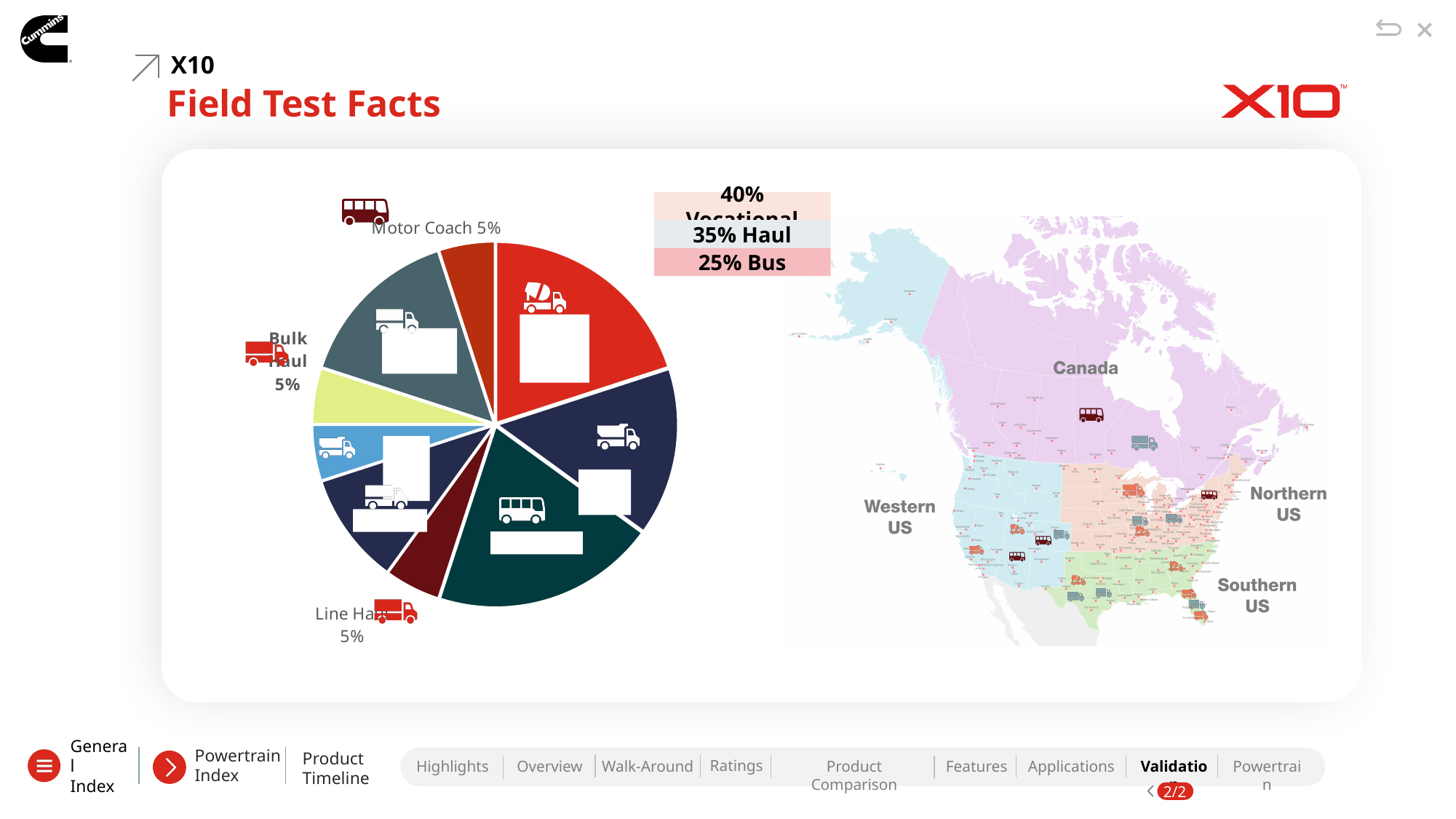
What kind of chart is shown on the left of the slide? pie chart What percentage does the Line Haul slice represent in the pie chart? 5% What is the difference between the Vocational share and the Bus share? 15% According to the summary boxes above the pie chart, what share is Vocational? 40% According to the summary boxes above the pie chart, what share is Haul? 35% According to the summary boxes above the pie chart, what share is Bus? 25% What is the title of the slide containing the pie chart? Field Test Facts What percentage does the Motor Coach slice represent in the pie chart? 5% Which of the three summary groups (Vocational, Haul, Bus) has the smallest share? Bus Which is larger, the Haul share or the Bus share? Haul What percentage does the Bulk Haul slice represent in the pie chart? 5% Which of the three summary groups (Vocational, Haul, Bus) has the largest share? Vocational